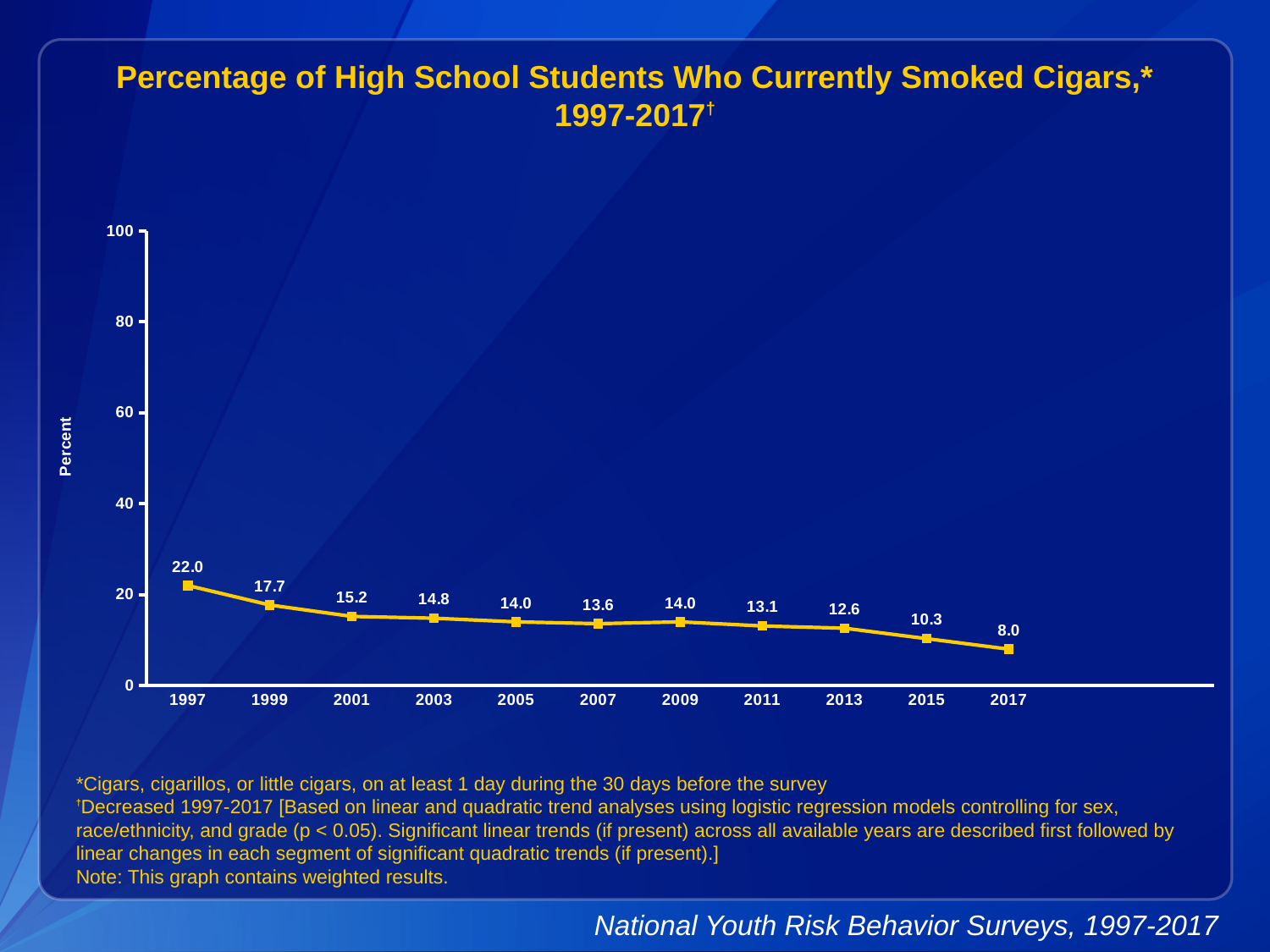
Do the values generally rise or fall from 1997 to 2017? Fall By how many percentage points did the value fall from 1997 to 2017? 14.0 Which year has a larger value, 1999 or 2001? 1999 Which year has the highest percentage of students who currently smoked cigars? 1997 What is the difference between the values for 2015 and 2017? 2.3 What kind of chart is shown on the slide? Line chart What was the percentage of high school students who currently smoked cigars in 1997? 22.0 What was the percentage of high school students who currently smoked cigars in 2017? 8.0 Which year has the lowest percentage of students who currently smoked cigars? 2017 How many years are plotted on the chart? 11 Is the value for 1997 greater or less than 20? greater What value is plotted for 2005? 14.0